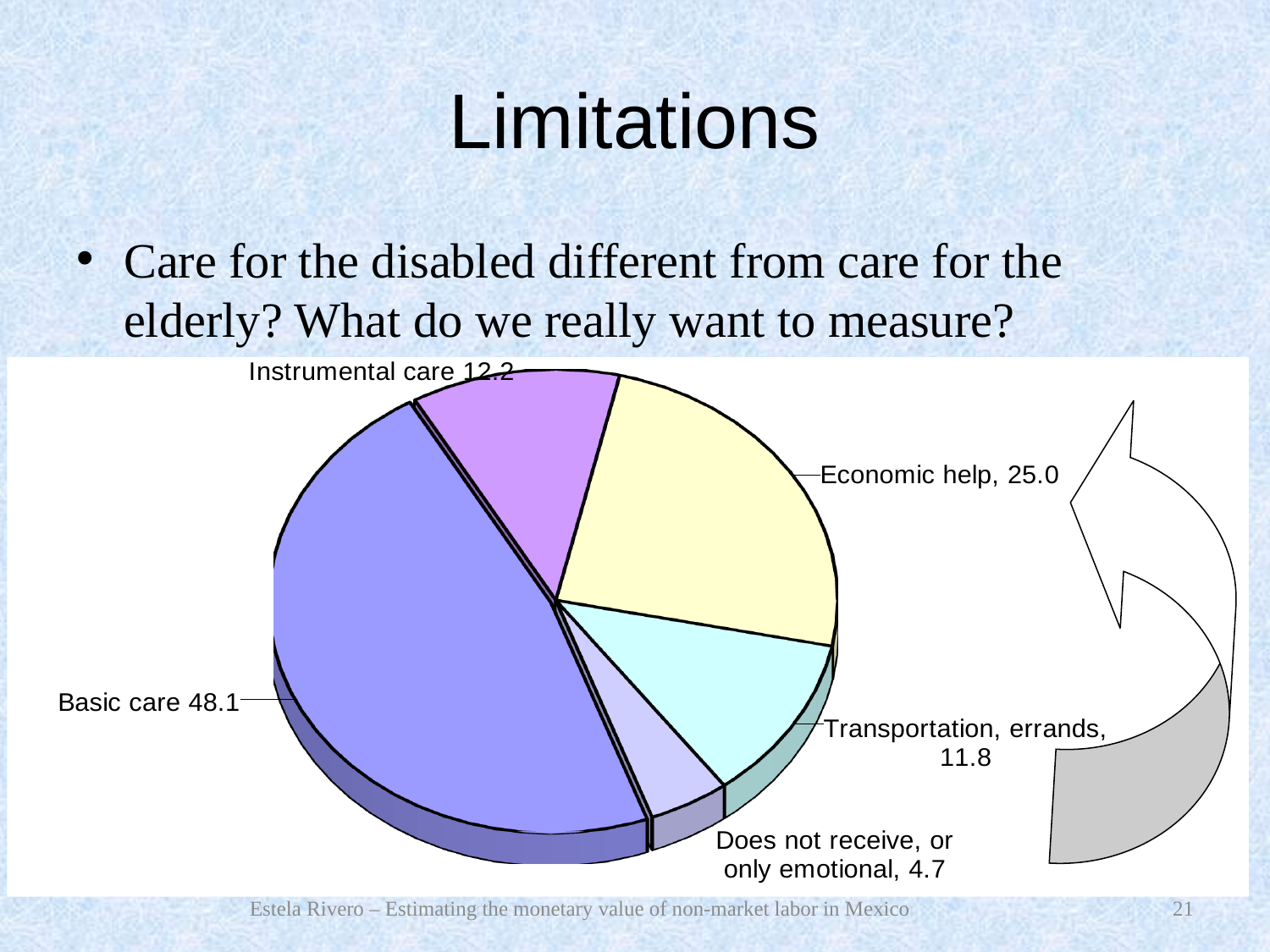
What is the value for Transportation, errands in the pie chart? 11.8 What is the value for Economic help in the pie chart? 25.0 How many slices does the pie chart have? 5 What kind of chart is shown on the slide? pie chart What is the value for Does not receive, or only emotional in the pie chart? 4.7 What is the value for Instrumental care in the pie chart? 12.2 Which is larger, the value for Economic help or the value for Instrumental care? Economic help What is the difference between the values for Economic help and Does not receive, or only emotional? 20.3 Which category has the smallest slice in the pie chart? Does not receive, or only emotional What is the value for Basic care in the pie chart? 48.1 Which category has the largest slice in the pie chart? Basic care What is the difference between the values for Basic care and Economic help? 23.1